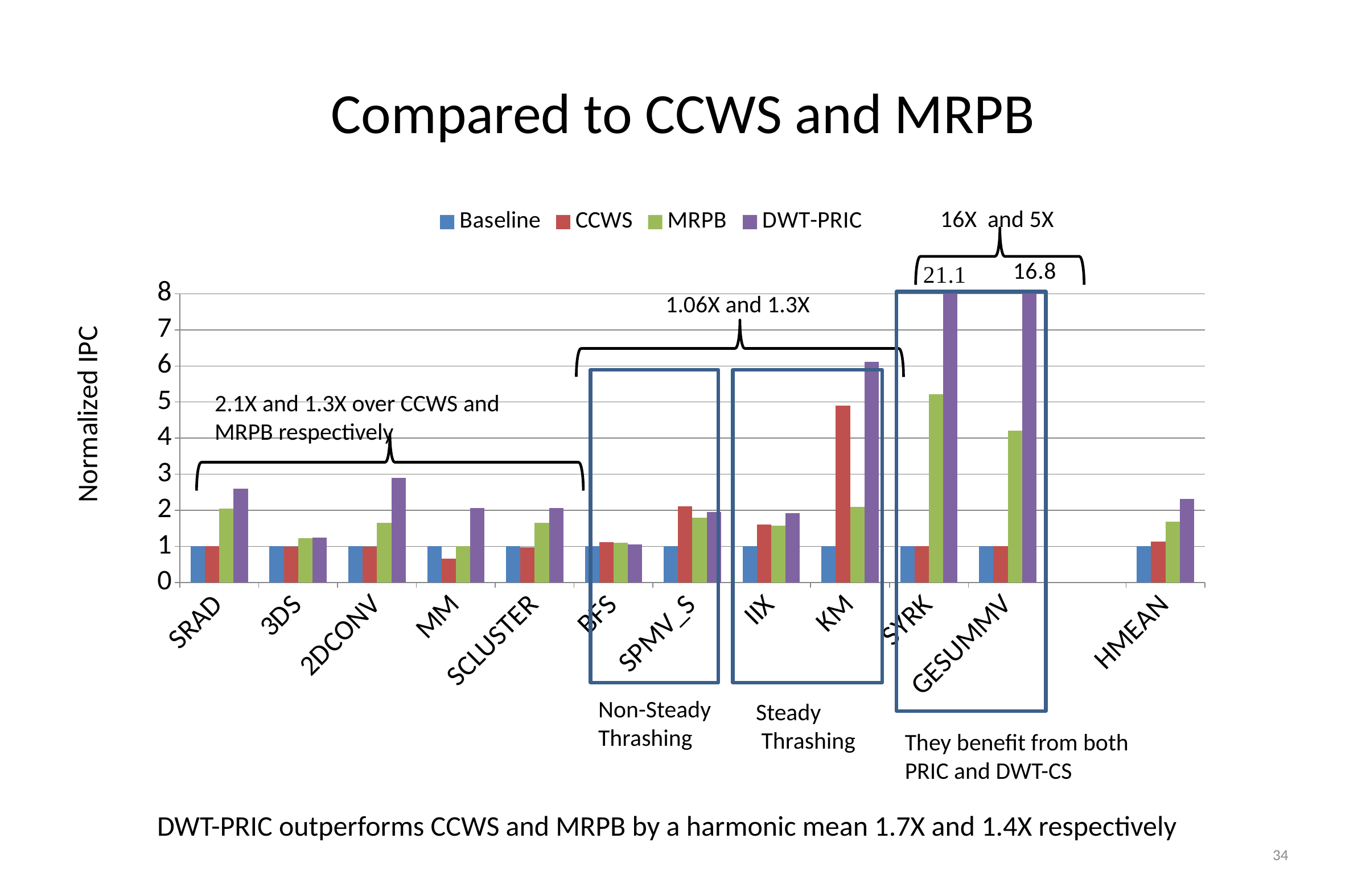
What is the label on the y axis? Normalized IPC What kind of chart is shown on the slide? bar chart What is the difference between the DWT-PRIC values for SYRK and GESUMMV? 4.3 Is the MRPB value for GESUMMV greater or less than 3? greater Which category has the highest DWT-PRIC value? SYRK Which category has the lowest CCWS value? MM How many categories are shown along the x axis? 12 What is the DWT-PRIC value for GESUMMV? 16.8 How many series does the legend list? 4 Is the CCWS value for KM greater or less than 4? greater Is the CCWS value for MM greater or less than 1? less What is the DWT-PRIC value for SYRK? 21.1